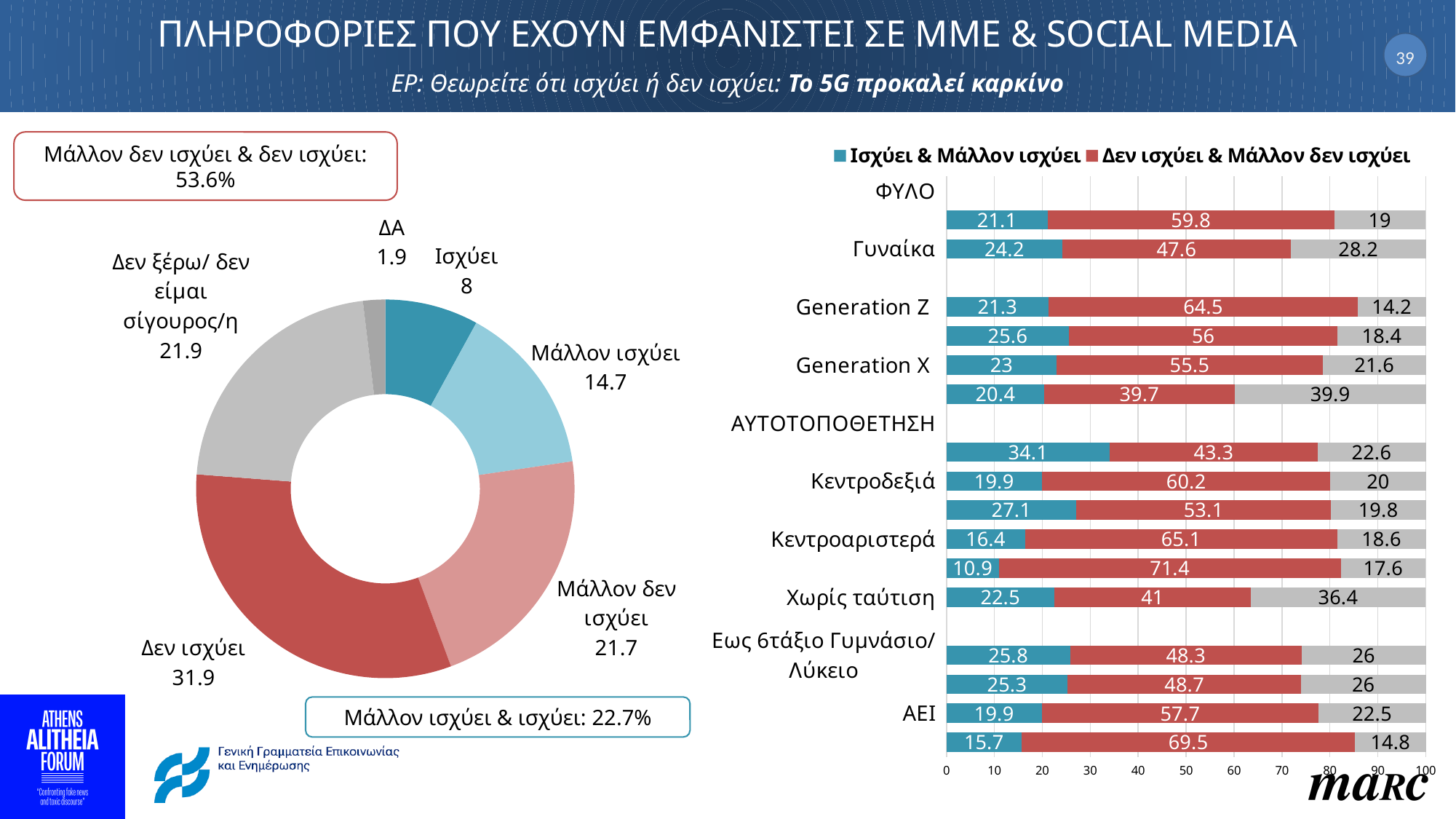
In the donut chart on the left, what is the difference between Δεν ισχύει and Μάλλον δεν ισχύει? 10.2 In the donut chart on the left, what is the value for Δεν ισχύει? 31.9 In the bar chart on the right, what is the value of Ισχύει & Μάλλον ισχύει for Γυναίκα? 24.2 In the bar chart on the right, what is the value of Δεν ισχύει & Μάλλον δεν ισχύει for Κεντροαριστερά? 65.1 In the bar chart on the right, which has the larger Ισχύει & Μάλλον ισχύει value, Κεντροδεξιά or Κεντροαριστερά? Κεντροδεξιά In the donut chart on the left, which category has the largest slice? Δεν ισχύει In the bar chart on the right, what is the difference in Δεν ισχύει & Μάλλον δεν ισχύει between Generation Z and Generation X? 9 In the donut chart on the left, which category has the smallest slice? ΔΑ How many slices does the donut chart on the left have? 6 What kind of chart is the chart on the right of the slide? Bar chart What kind of chart is the chart on the left of the slide? Donut (pie) chart How many series does the legend of the bar chart on the right list? 2